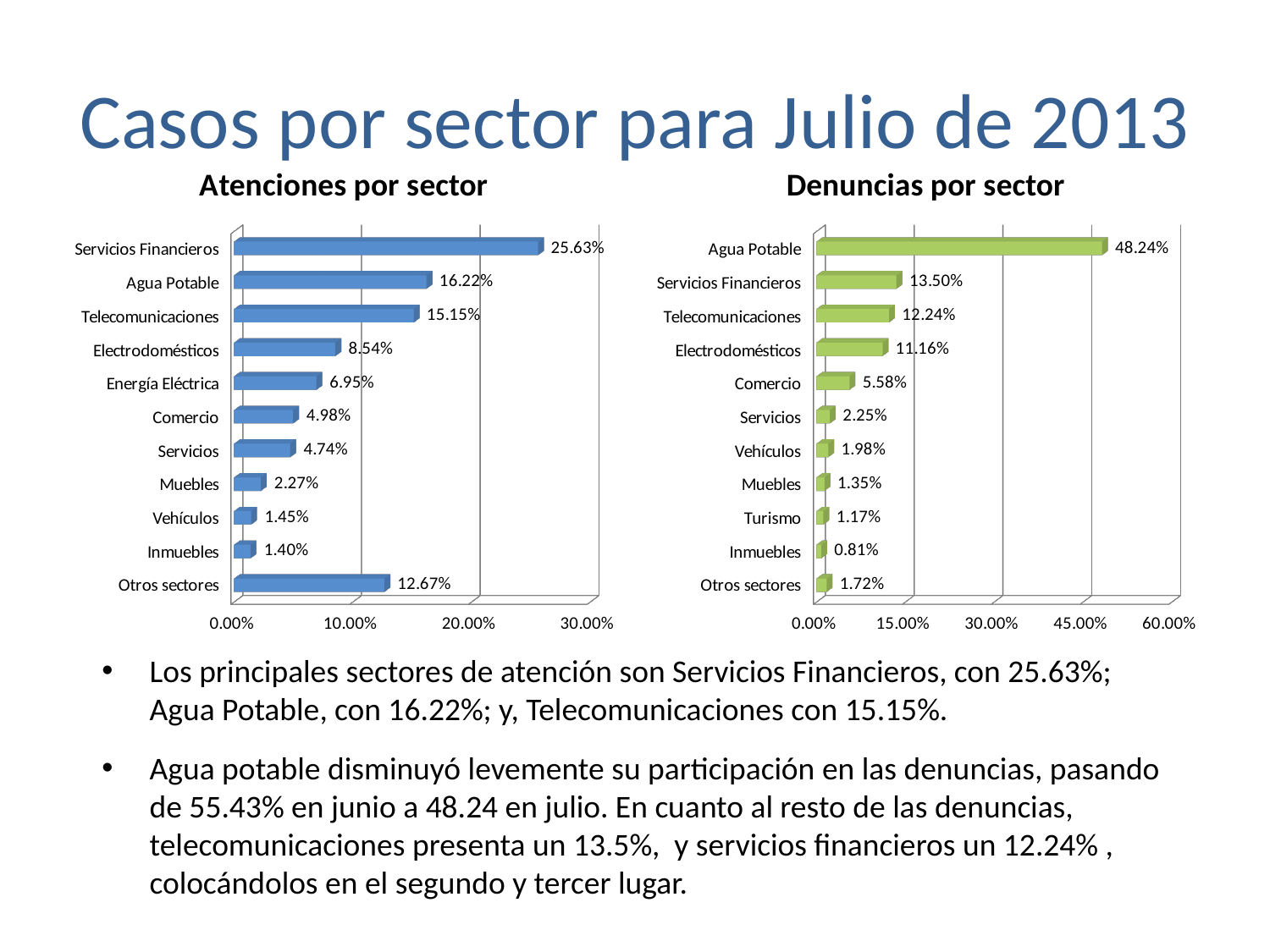
What colour are the bars in the 'Denuncias por sector' chart? Green In the 'Denuncias por sector' chart, which sector has the highest value? Agua Potable In the 'Atenciones por sector' chart, what is the difference between Agua Potable and Telecomunicaciones? 1.07% In the 'Denuncias por sector' chart, what is the value for Agua Potable? 48.24% In the 'Atenciones por sector' chart, is the value for Otros sectores greater or less than 10.00%? greater In the 'Atenciones por sector' chart, which sector has the lowest value? Inmuebles In the 'Denuncias por sector' chart, which is larger: Servicios Financieros or Telecomunicaciones? Servicios Financieros What kind of chart is 'Atenciones por sector'? Bar chart In the 'Denuncias por sector' chart, what is the value for Turismo? 1.17% In the 'Denuncias por sector' chart, what is the difference between Agua Potable and Servicios Financieros? 34.74% How many sectors are shown in the 'Denuncias por sector' chart? 11 In the 'Atenciones por sector' chart, what is the value for Servicios Financieros? 25.63%